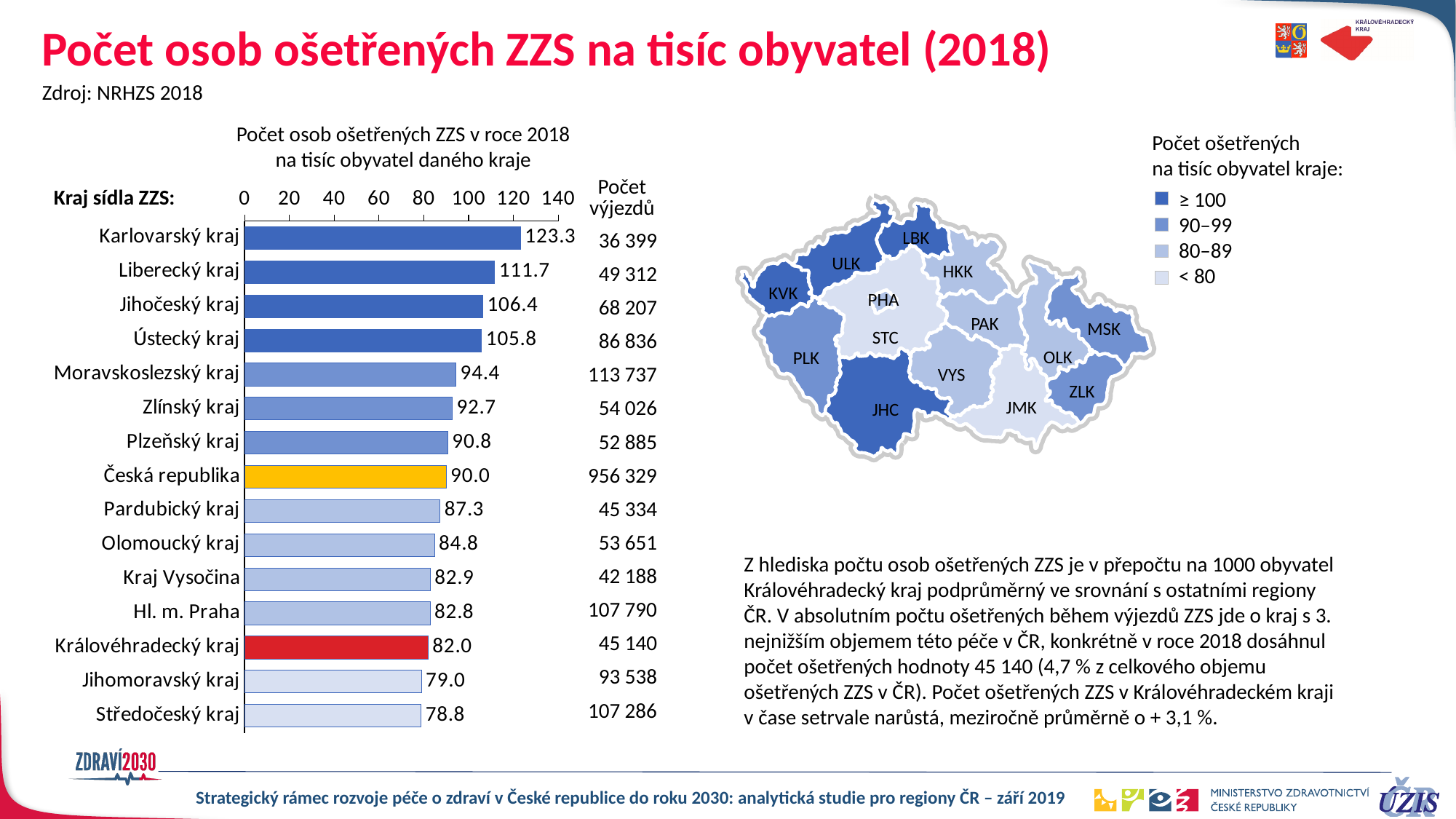
In the bar chart, what is the value for Karlovarský kraj? 123.3 In the bar chart, what is the value for Česká republika? 90.0 In the bar chart, what is the value for Hl. m. Praha? 82.8 In the bar chart, what is the value for Královéhradecký kraj? 82.0 What type of chart is shown on the left of the slide? bar chart What colour is the bar for Královéhradecký kraj in the bar chart? red Which category has the lowest value in the bar chart? Středočeský kraj Is the value for Moravskoslezský kraj in the bar chart greater or less than 100? less Which category has the highest value in the bar chart? Karlovarský kraj In the bar chart, which has the larger value, Liberecký kraj or Jihočeský kraj? Liberecký kraj What is the difference between the values for Karlovarský kraj and Královéhradecký kraj in the bar chart? 41.3 How many bars are shown in the bar chart? 15